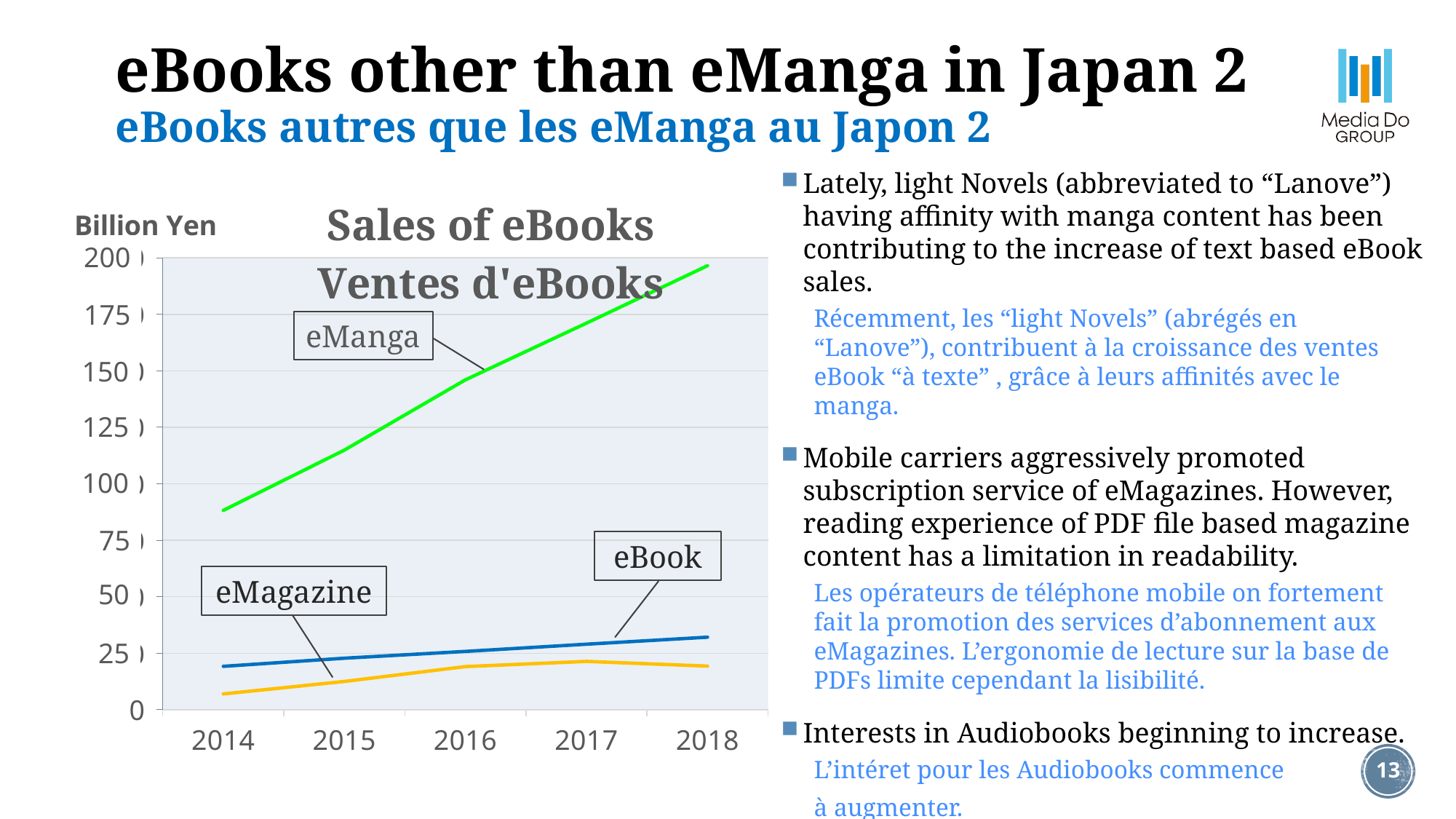
Is the value for eBook in 2018 greater or less than 25? greater In 2018, which is larger: eBook or eMagazine? eBook Which series has the highest value in 2018? eManga What kind of chart is shown on the slide? line chart Is the value for eManga in 2018 greater or less than 175? greater How many years are plotted along the x axis of the Sales of eBooks chart? 5 Is the value for eManga in 2014 greater or less than 100? less What unit is shown for the y axis of the chart? Billion Yen Does the eManga series rise or fall from 2014 to 2018? rise Which series has the lowest value in 2014? eMagazine How many series are labelled on the Sales of eBooks chart? 3